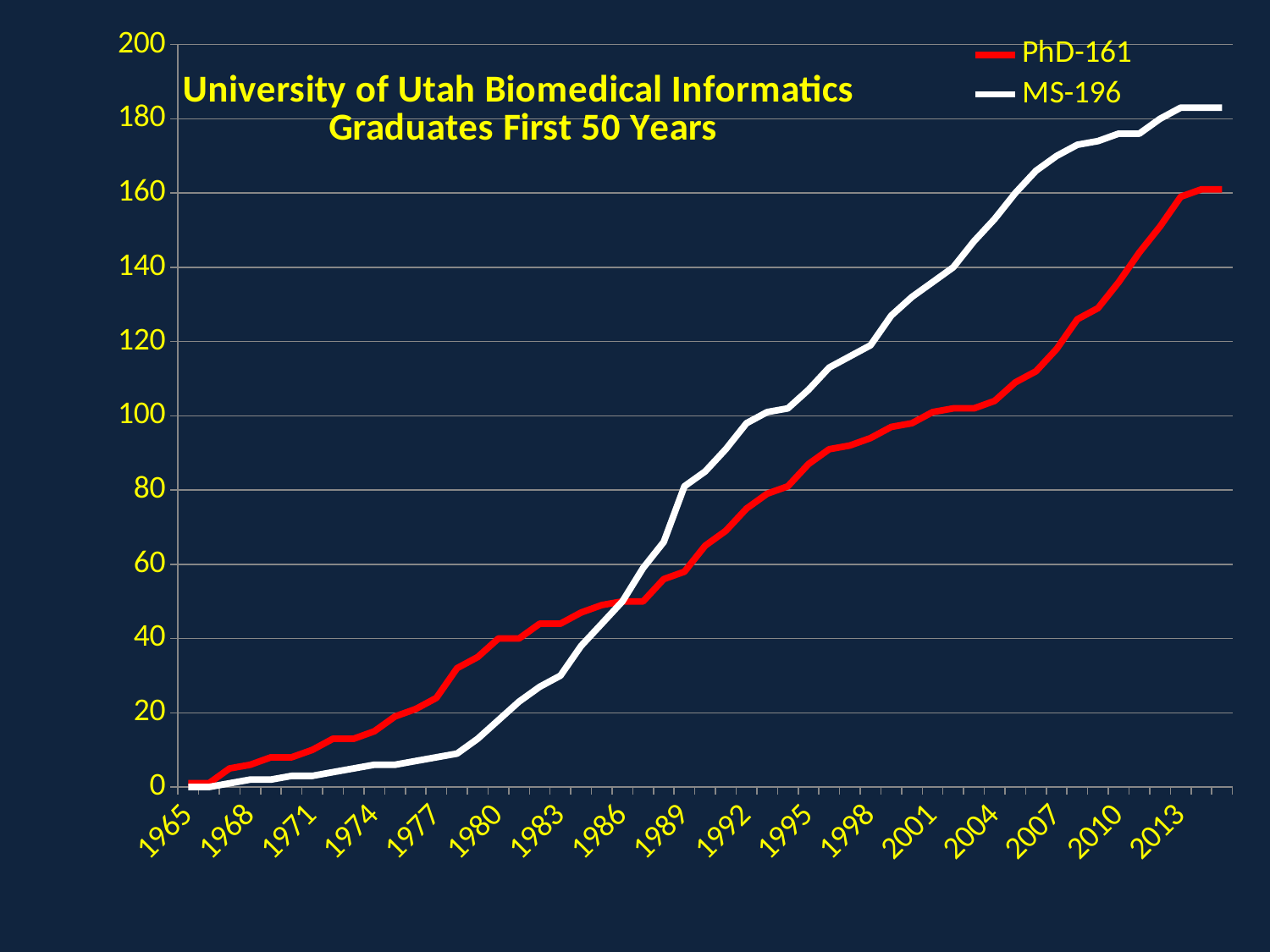
How many series does the legend list? 2 Do the values of the MS-196 series rise or fall from 1965 to 2013? rise What is the title of the chart? University of Utah Biomedical Informatics Graduates First 50 Years Is the value for MS-196 in 2001 greater or less than 120? greater Is the value for PhD-161 in 2001 greater or less than 120? less What colour is the PhD-161 line? red In 1977, which series has the higher value, PhD-161 or MS-196? PhD-161 Is the value for PhD-161 in 2013 greater or less than 140? greater What kind of chart is shown on the slide? line chart In 2013, which series has the higher value, PhD-161 or MS-196? MS-196 Do the values of the PhD-161 series rise or fall along the x axis? rise